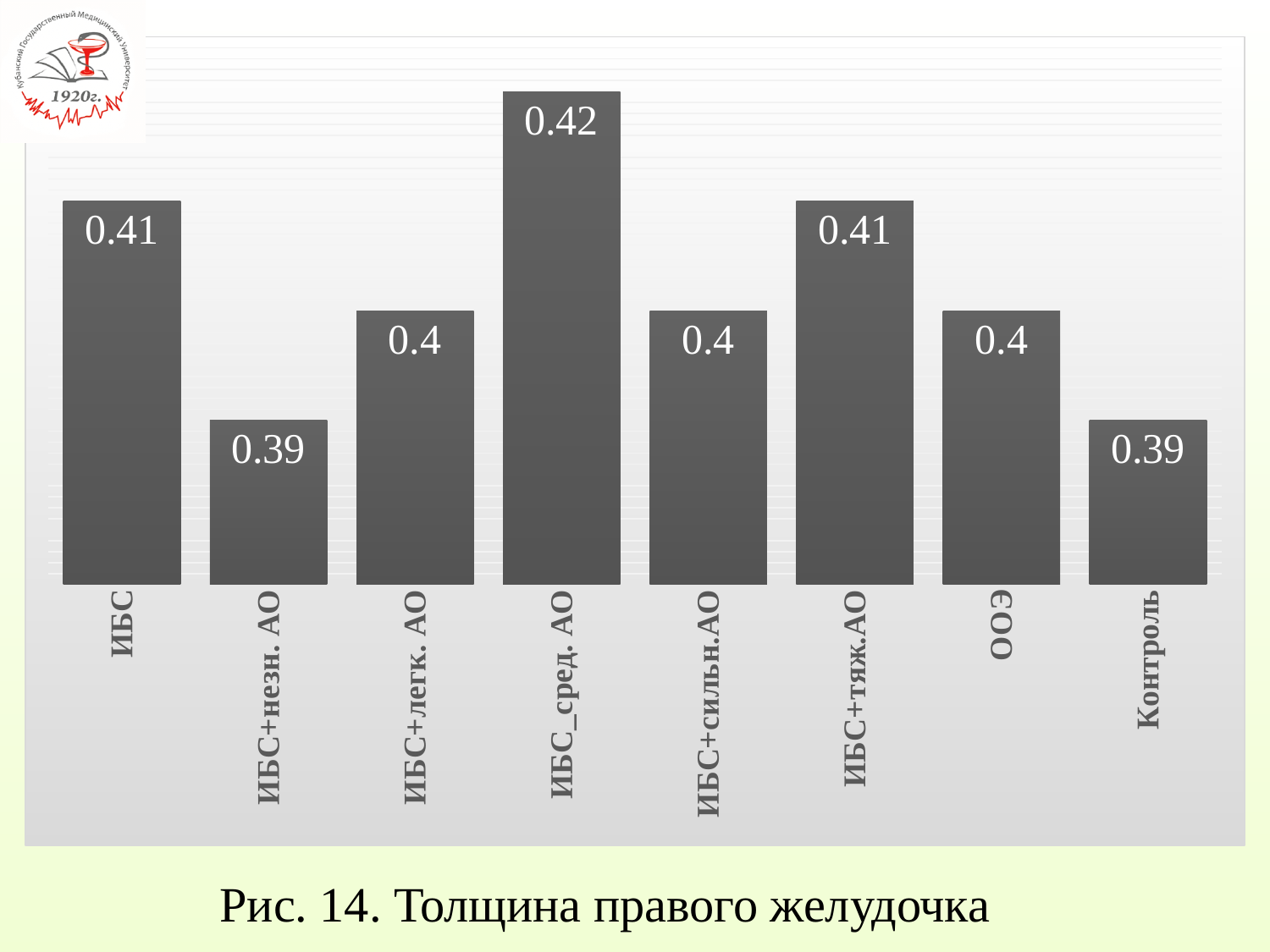
What kind of chart is shown on the slide? Bar chart Which is larger, the value for ИБС_сред. АО or the value for ИБС+сильн.АО? ИБС_сред. АО Which category has the highest value? ИБС_сред. АО What is the difference between the values for ИБС_сред. АО and Контроль? 0.03 Which is larger, the value for ИБС or the value for ИБС+незн. АО? ИБС What is the value for ИБС_сред. АО? 0.42 What is the value for Контроль? 0.39 What is the difference between the values for ИБС and ИБС+легк. АО? 0.01 How many categories are shown in the chart? 8 What is the value for ИБС+тяж.АО? 0.41 What is the value for ИБС+незн. АО? 0.39